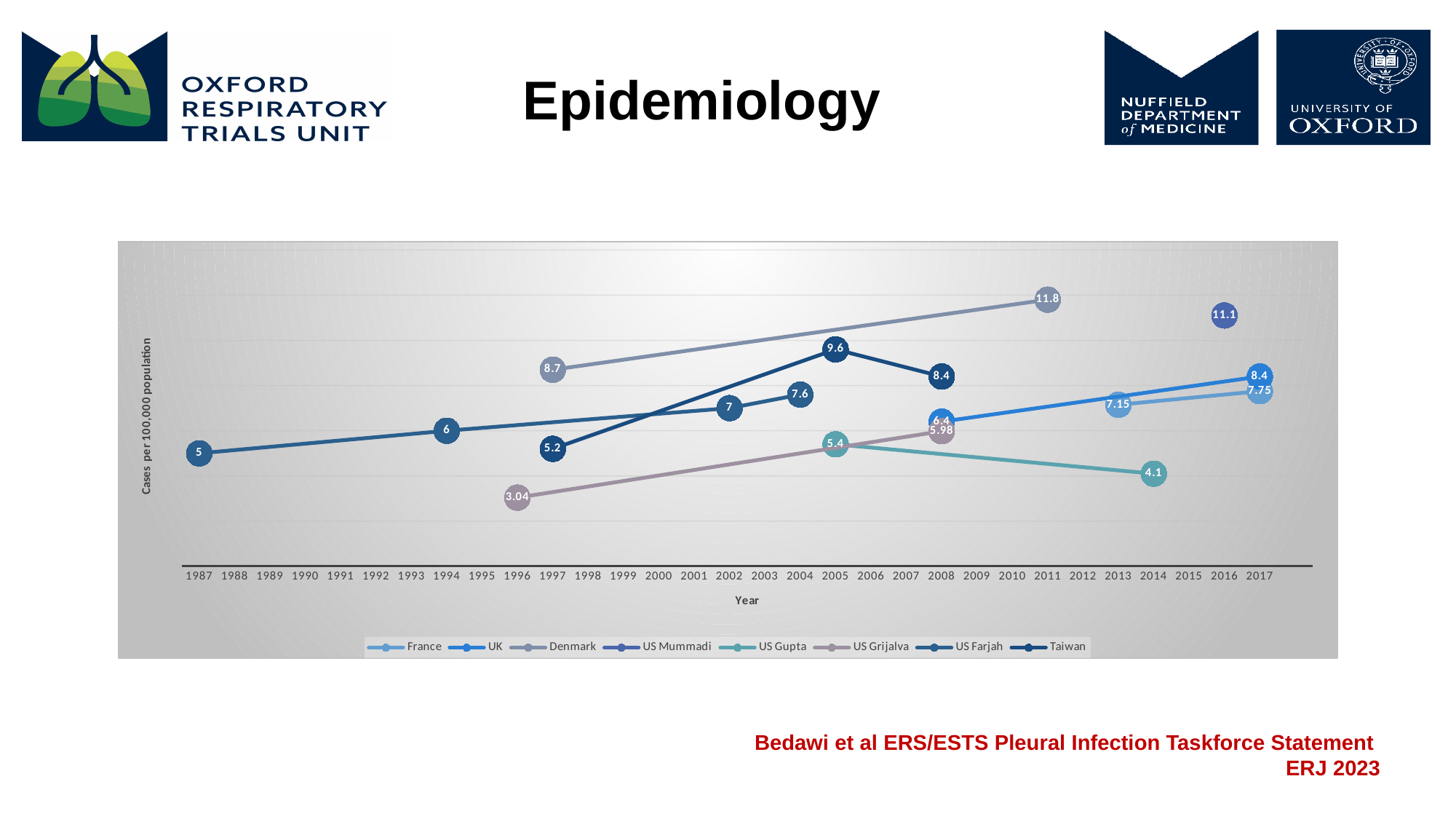
By how much did the Denmark value increase from 1997 to 2011? 3.1 Which series has the highest plotted value on the chart? Denmark Which series has the lowest plotted value on the chart? US Grijalva What is the label on the vertical axis? Cases per 100,000 population What type of chart is shown on the slide? Line chart What is the value for US Grijalva in 1996? 3.04 Does the US Farjah series rise or fall from 1987 to 2004? Rise What is the value for US Mummadi in 2016? 11.1 What is the difference between the US Gupta values in 2005 and 2014? 1.3 What is the value for Denmark in 2011? 11.8 What is the value for Taiwan in 2005? 9.6 How many series does the legend list? 8